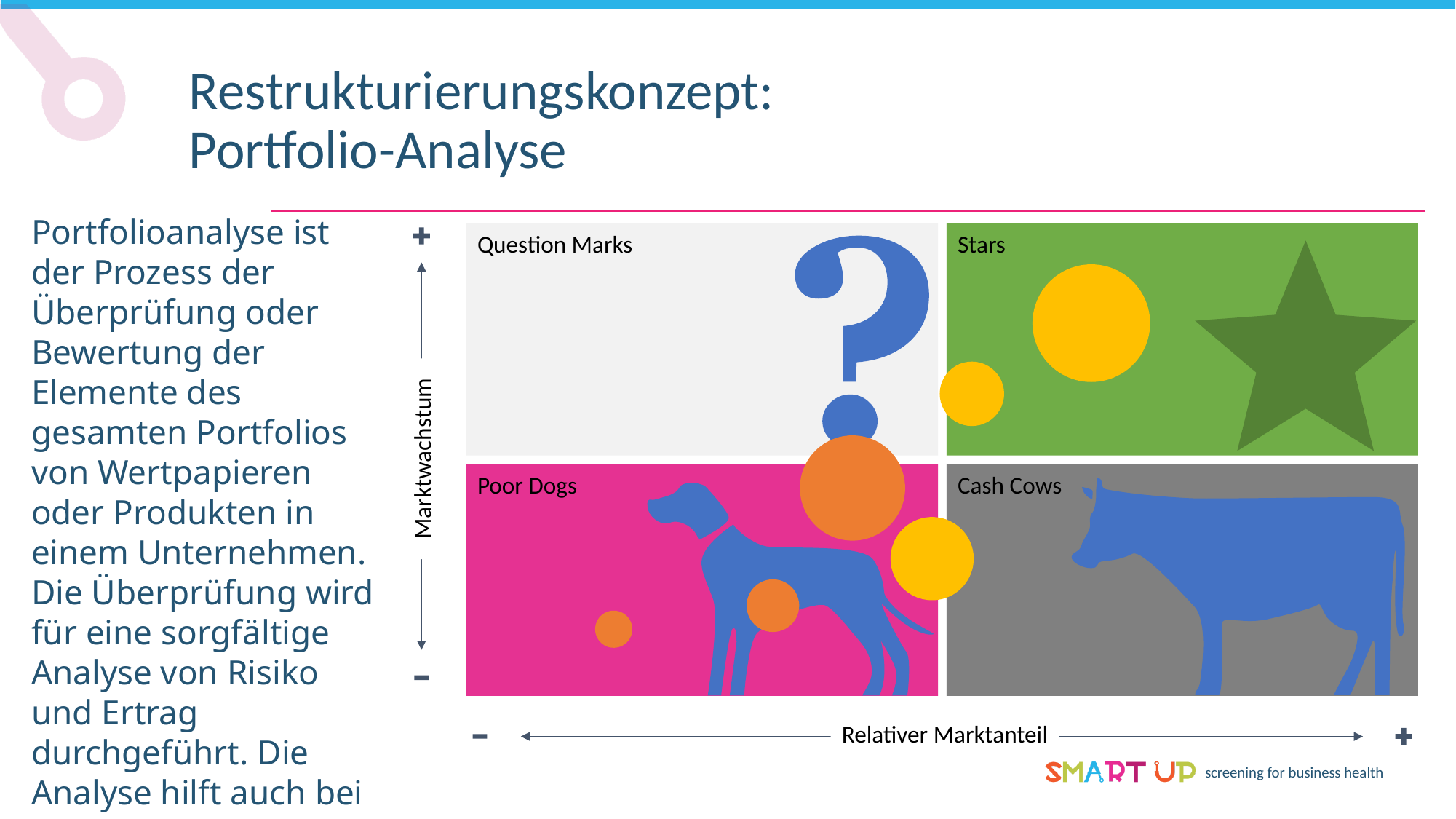
Which quadrant of the portfolio matrix is in the bottom-left position? Poor Dogs Which quadrant of the portfolio matrix is labelled 'Cash Cows'? bottom-right How many quadrants does the portfolio matrix have? 4 How many circles (bubbles) are plotted on the portfolio matrix? 6 Which quadrant of the portfolio matrix is labelled 'Question Marks'? top-left How many orange circles are plotted on the portfolio matrix? 3 Which quadrant of the portfolio matrix is in the top-right position? Stars What label is shown on the horizontal axis of the portfolio matrix? Relativer Marktanteil What label is shown on the vertical axis of the portfolio matrix? Marktwachstum